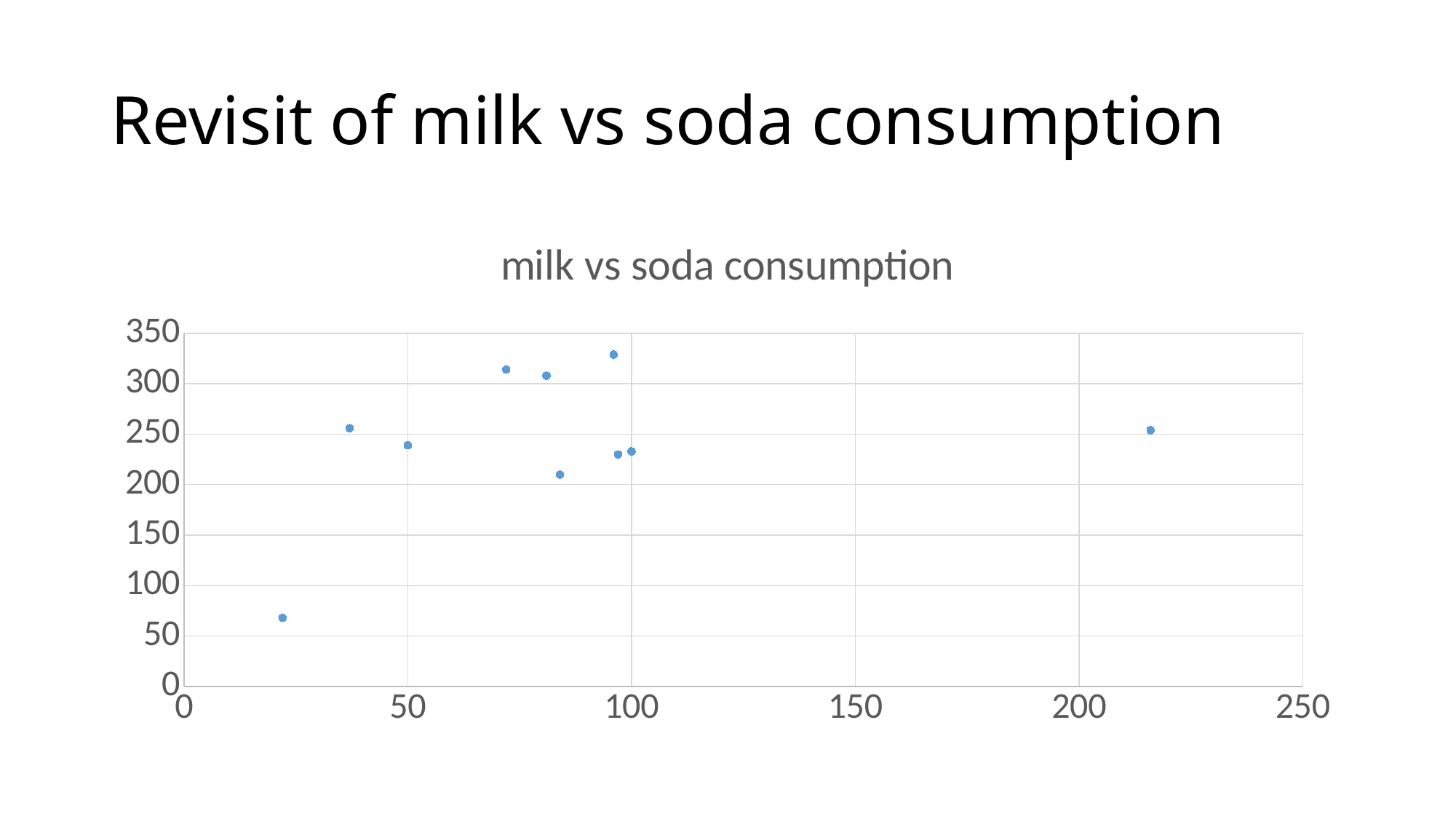
How many data points are plotted in the chart? 10 How many points in the chart have an x value greater than 150? 1 Is the y value of the lowest point in the chart greater or less than 100? less Which has the larger y value: the leftmost point or the rightmost point in the chart? the rightmost point Is the y value of the highest point in the chart greater or less than 300? greater Is the x value of the rightmost point in the chart greater or less than 200? greater What is the maximum value shown on the y axis of the chart? 350 What kind of chart is shown on the slide? scatter plot What is the title of the chart? milk vs soda consumption How many points in the chart have a y value above 300? 3